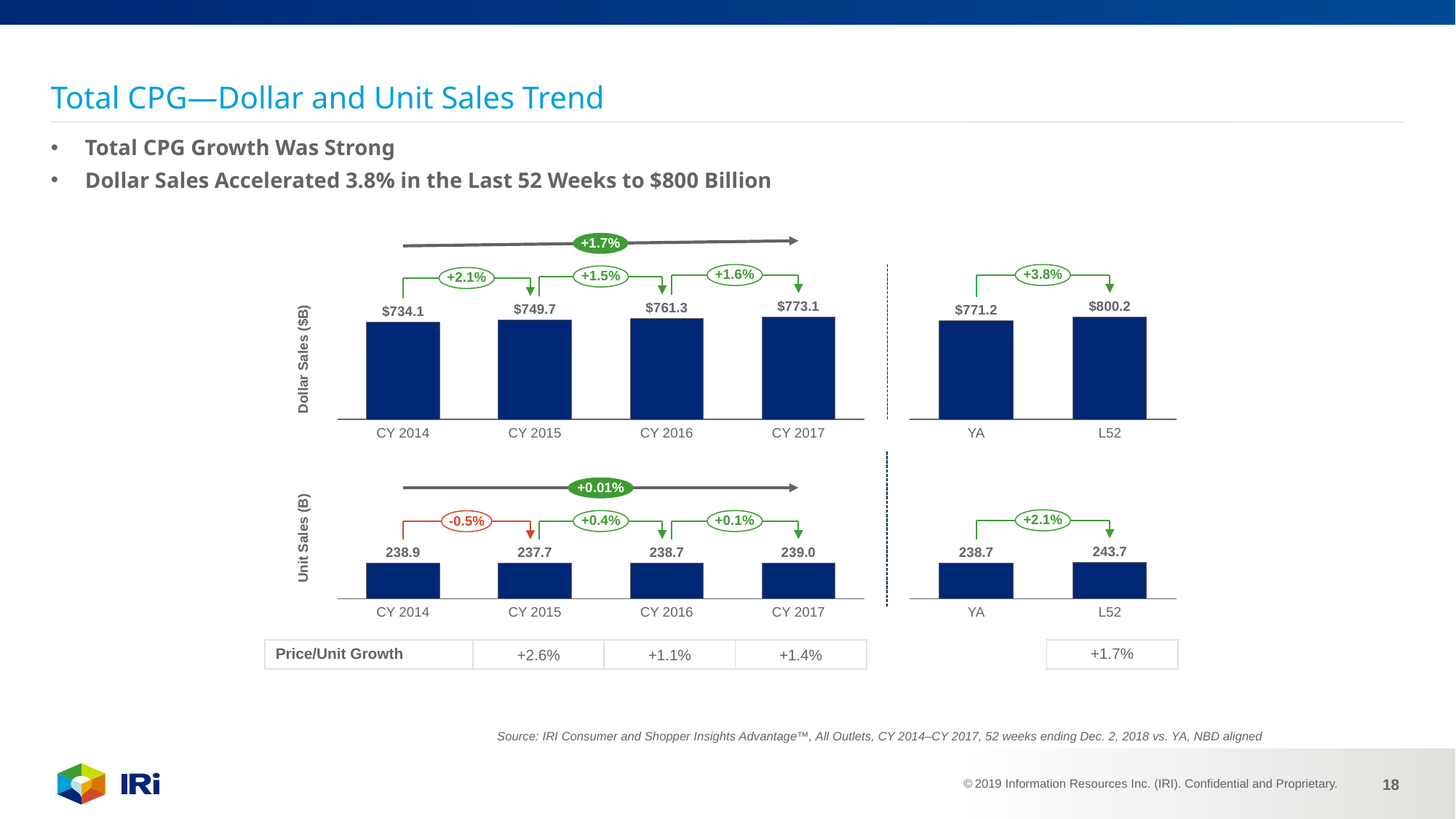
In the Dollar Sales ($B) chart for CY 2014–CY 2017, which year has the highest value? CY 2017 In the Unit Sales (B) chart for CY 2014–CY 2017, which is larger, CY 2014 or CY 2015? CY 2014 In the Unit Sales (B) chart for CY 2014–CY 2017, what is the value for CY 2015? 237.7 In the Dollar Sales ($B) chart on the right (YA vs L52), what is the difference between L52 and YA? $29.0 In the Dollar Sales ($B) chart on the right (YA vs L52), what is the value for L52? $800.2 In the Dollar Sales ($B) chart for CY 2014–CY 2017, which year has the lowest value? CY 2014 Do the values in the Dollar Sales ($B) chart for CY 2014–CY 2017 rise or fall from CY 2014 to CY 2017? rise What kind of chart is the Unit Sales (B) chart for CY 2014–CY 2017? bar chart How many bars are in the Dollar Sales ($B) chart for CY 2014–CY 2017? 4 In the Dollar Sales ($B) chart for CY 2014–CY 2017, what is the difference between CY 2017 and CY 2014? $39.0 In the Unit Sales (B) chart on the right (YA vs L52), what is the value for L52? 243.7 In the Dollar Sales ($B) chart for CY 2014–CY 2017, what is the value for CY 2016? $761.3